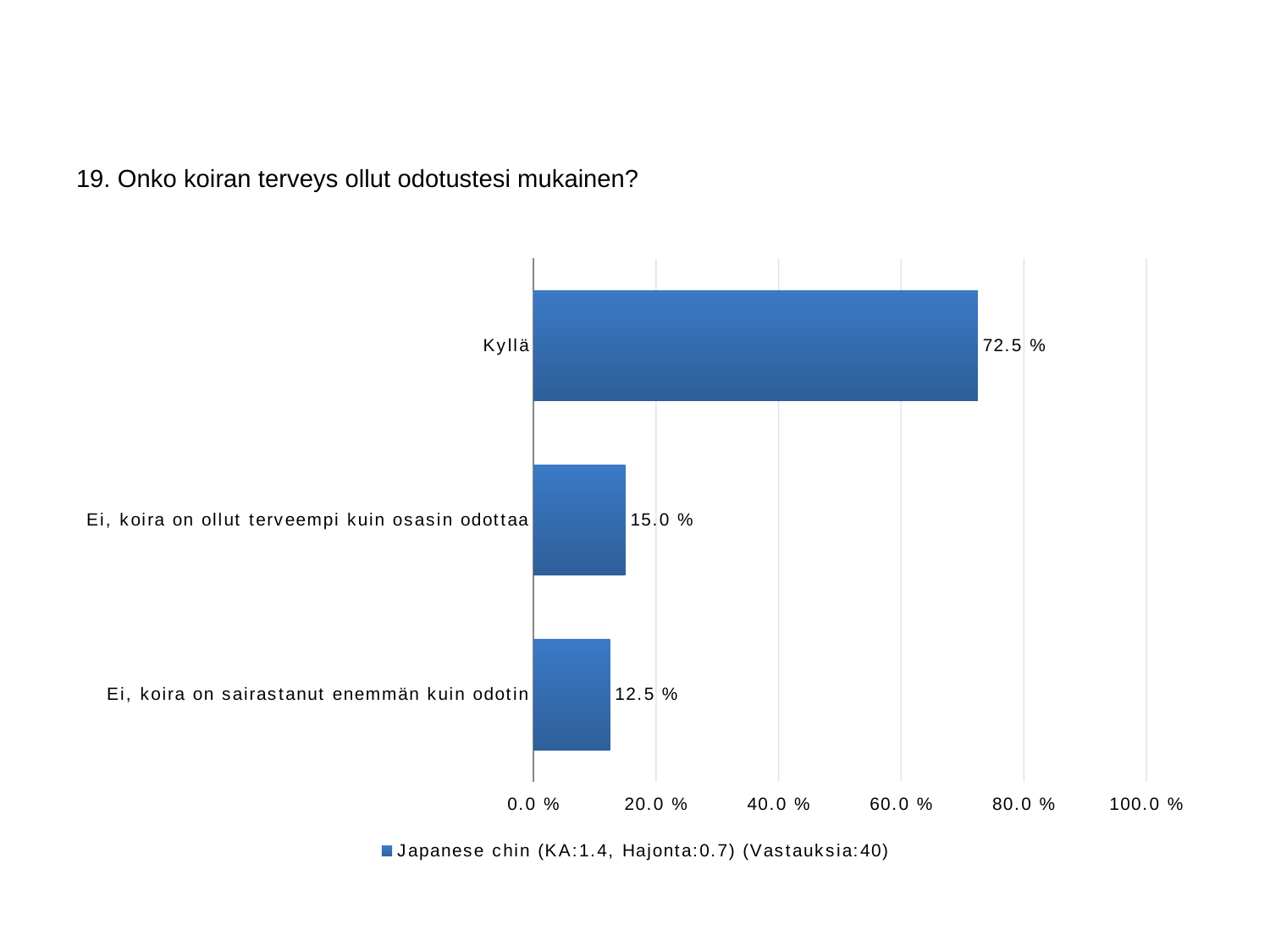
What is the value for "Ei, koira on ollut terveempi kuin osasin odottaa"? 15.0 % What is the difference between the values for "Kyllä" and "Ei, koira on ollut terveempi kuin osasin odottaa"? 57.5 % Is the value for "Kyllä" greater or less than 60.0 %? greater What is the legend entry shown below the chart? Japanese chin (KA:1.4, Hajonta:0.7) (Vastauksia:40) What is the difference between the values for "Ei, koira on ollut terveempi kuin osasin odottaa" and "Ei, koira on sairastanut enemmän kuin odotin"? 2.5 % How many categories are shown in the chart? 3 What is the value for "Ei, koira on sairastanut enemmän kuin odotin"? 12.5 % What is the value for "Kyllä"? 72.5 % Which category has the highest value? Kyllä Which category has the lowest value? Ei, koira on sairastanut enemmän kuin odotin What kind of chart is shown on the slide? Bar chart Which is larger, the value for "Kyllä" or the value for "Ei, koira on sairastanut enemmän kuin odotin"? Kyllä